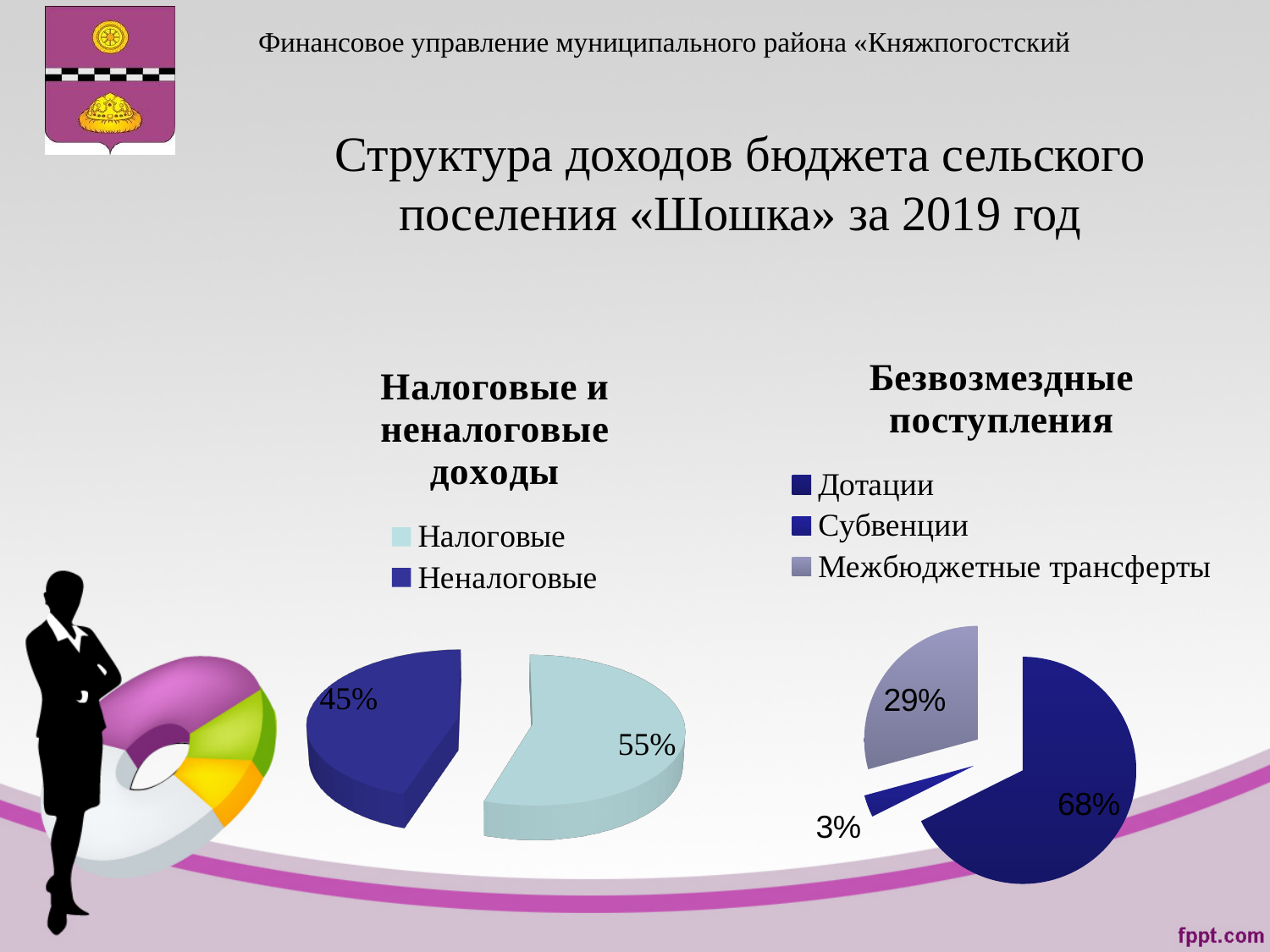
In the chart titled «Налоговые и неналоговые доходы», what share is labelled for Неналоговые? 45% In the chart titled «Безвозмездные поступления», which category has the largest slice? Дотации How many categories does the legend of the chart titled «Безвозмездные поступления» list? 3 What kind of chart is the chart titled «Налоговые и неналоговые доходы»? Pie chart In the chart titled «Безвозмездные поступления», what is the difference between the Дотации and Межбюджетные трансферты shares? 39% In the chart titled «Безвозмездные поступления», what share is labelled for Межбюджетные трансферты? 29% In the chart titled «Налоговые и неналоговые доходы», what share is labelled for Налоговые? 55% In the chart titled «Безвозмездные поступления», what share is labelled for Дотации? 68% In the chart titled «Безвозмездные поступления», which category has the smallest slice? Субвенции In the chart titled «Налоговые и неналоговые доходы», which slice is larger, Налоговые or Неналоговые? Налоговые In the chart titled «Безвозмездные поступления», what share is labelled for Субвенции? 3% In the chart titled «Налоговые и неналоговые доходы», what is the difference between the Налоговые and Неналоговые shares? 10%